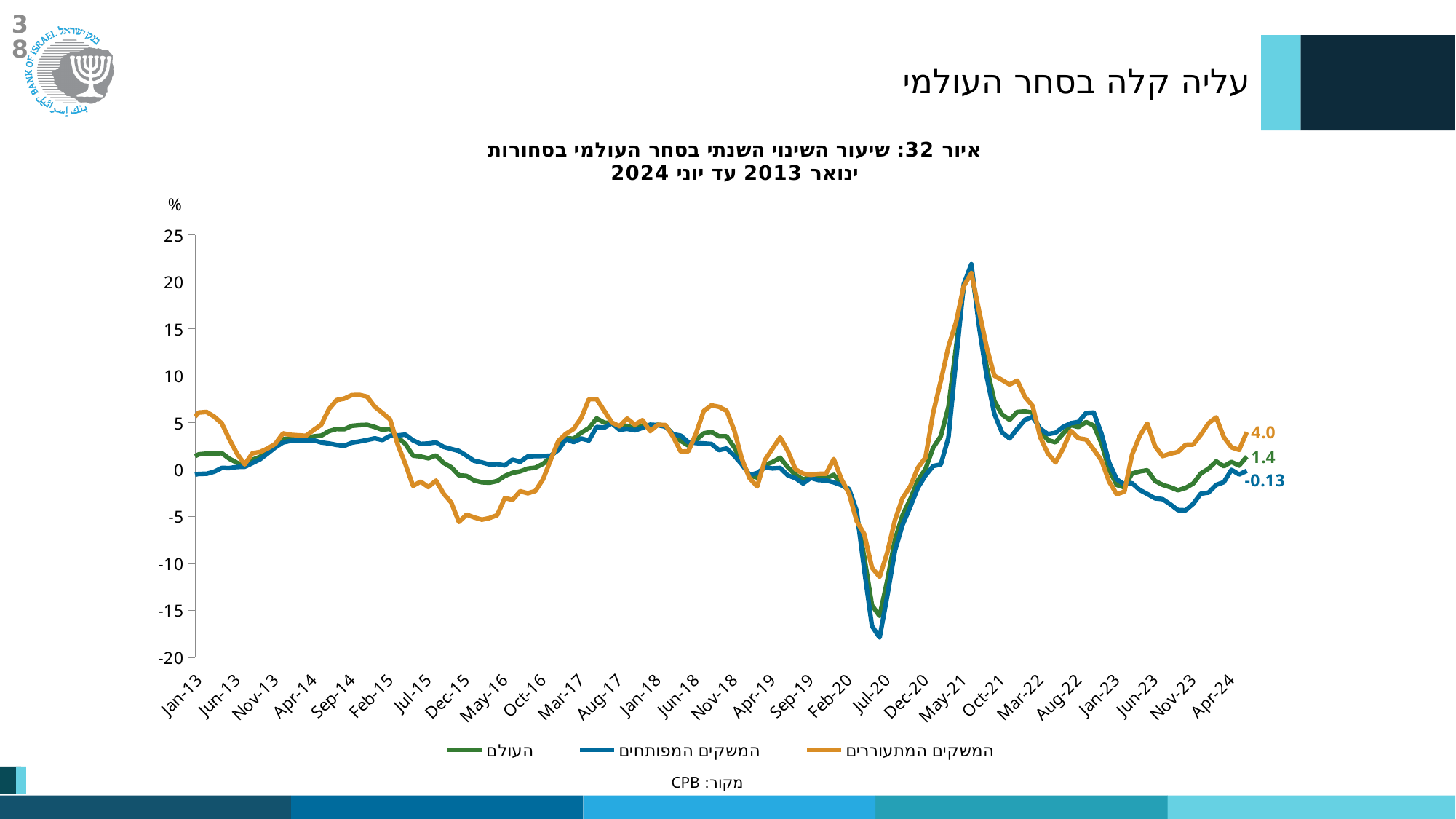
At the end of the chart, is the value for העולם larger or smaller than the value for המשקים המפותחים? larger Is the peak value of the המשקים המפותחים line around May-21 greater or less than 20? greater What type of chart is shown on the slide? line chart What source is cited below the chart? CPB How many series does the legend list? 3 Which series has the highest value at the end of the chart? המשקים המתעוררים What is the difference between the final values of המשקים המתעוררים (4.0) and העולם (1.4)? 2.6 What is the latest value shown for המשקים המתעוררים (emerging economies)? 4.0 What is the latest value shown for העולם (world)? 1.4 Is the lowest value of the המשקים המפותחים line around Jul-20 greater or less than -15? less What is the latest value shown for המשקים המפותחים (developed economies)? -0.13 Which series has the lowest value at the end of the chart? המשקים המפותחים